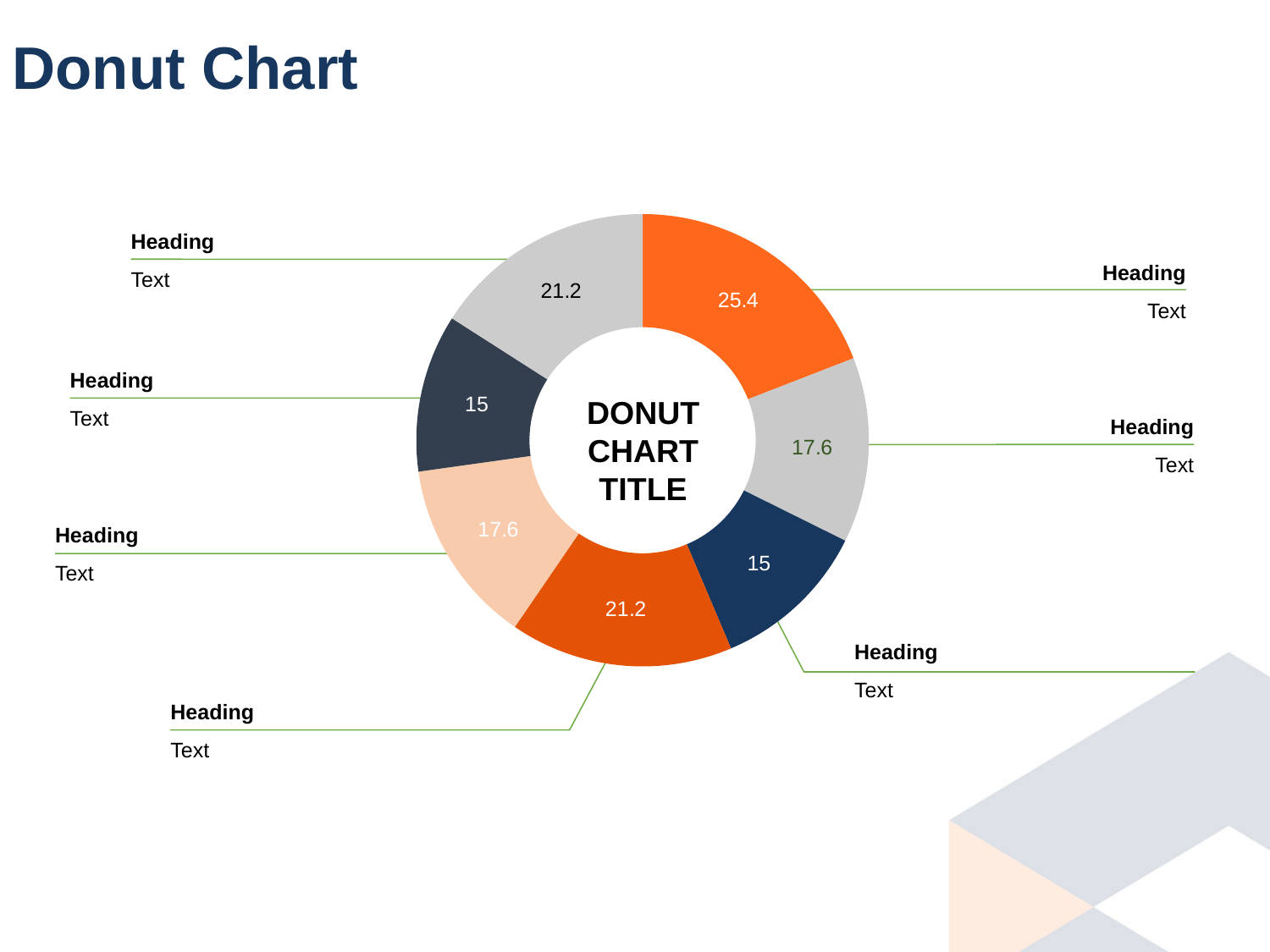
What is the difference between the largest slice value (25.4) and the 21.2 slices? 4.2 What is the largest value shown on any slice of the donut chart? 25.4 What is the sum of all the slice values in the donut chart? 133 What text is written in the centre of the donut chart? DONUT CHART TITLE What value is labelled on the light peach slice on the lower left of the donut? 17.6 What is the smallest value shown on any slice of the donut chart? 15 How many slices does the donut chart have? 7 What value is labelled on the dark red-orange slice at the bottom of the donut? 21.2 What kind of chart is shown on the slide? Donut chart What value is labelled on the bright orange slice at the top right of the donut? 25.4 Which is larger: the bright orange slice at the top right or the light grey slice at the top left? The bright orange slice (25.4) What is the difference between a 21.2 slice and a 15 slice? 6.2